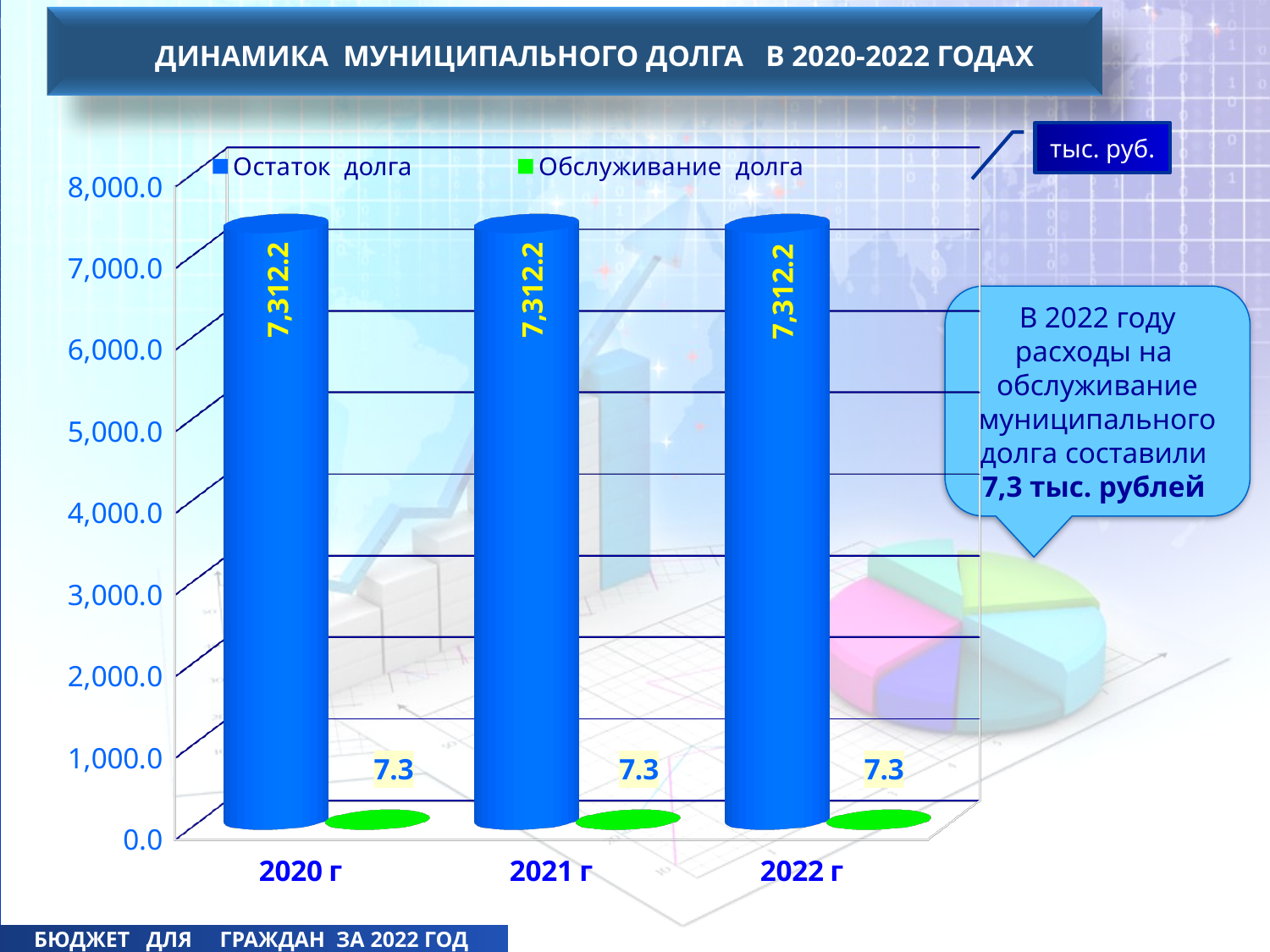
Does the value of Остаток долга rise, fall or stay the same from 2020 г to 2022 г? stays the same What is the difference between Остаток долга and Обслуживание долга in 2022 г? 7,304.9 What unit is indicated in the box at the top right of the chart? тыс. руб. Which series has the larger value in 2021 г, Остаток долга or Обслуживание долга? Остаток долга What is the value of Обслуживание долга for 2022 г? 7.3 How many year categories are shown on the x axis? 3 How many series does the legend list? 2 What is the value of Остаток долга for 2020 г? 7,312.2 What is the value of Обслуживание долга for 2021 г? 7.3 What kind of chart is shown on the slide? bar chart What is the value of Остаток долга for 2022 г? 7,312.2 Is the value of Остаток долга for 2021 г greater or less than 7,000.0? greater